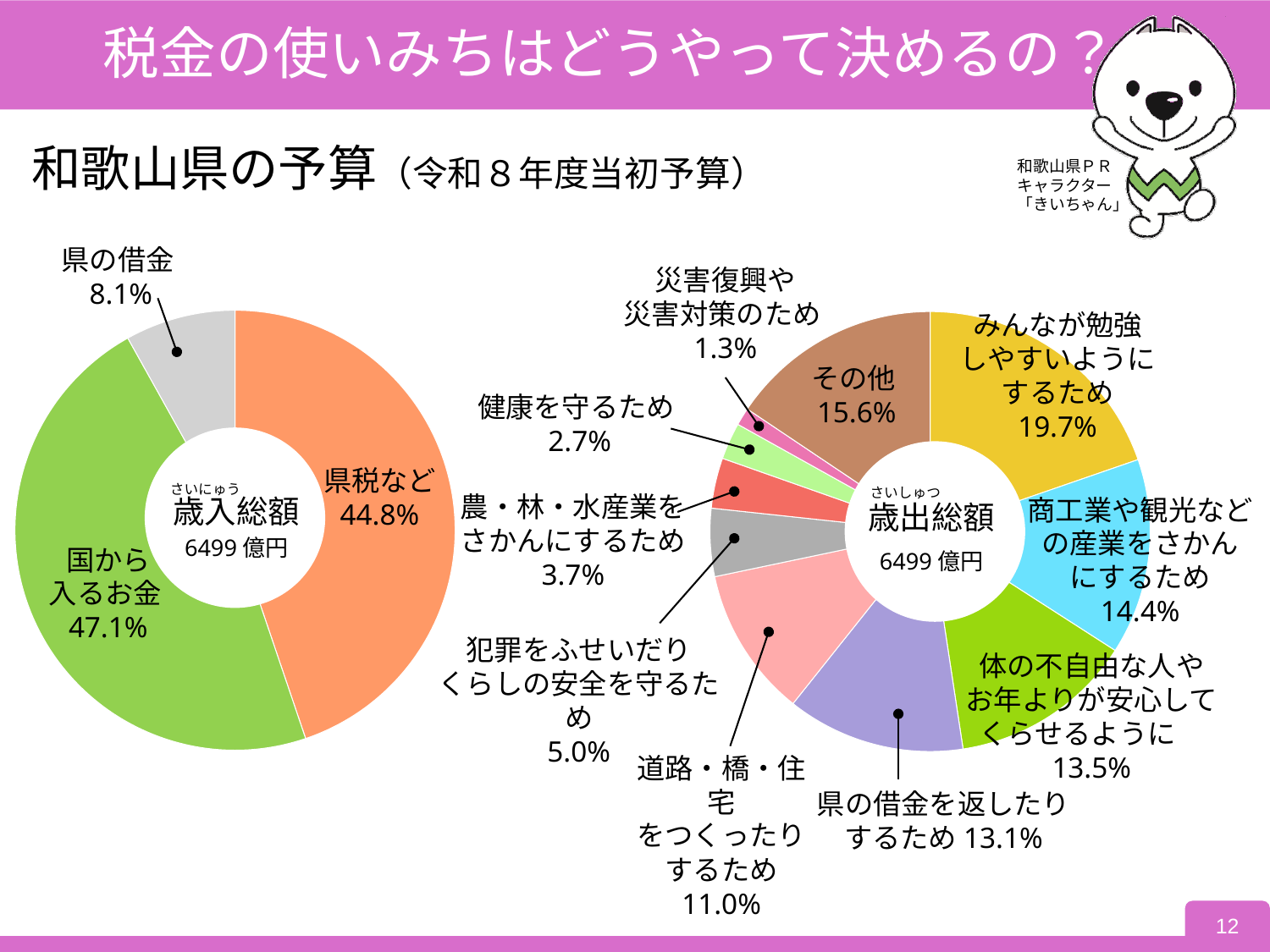
右の「歳出総額」のグラフで、最も割合が小さい項目はどれですか？ 災害復興や災害対策のため このスライドのグラフはどの種類のグラフですか？ 円グラフ（ドーナツグラフ） 右の「歳出総額」のグラフで、「その他」と「道路・橋・住宅をつくったりするため」では、どちらの割合が大きいですか？ その他 右の「歳出総額」のグラフには、いくつの項目がありますか？ 10 左の「歳入総額」のグラフには、いくつの項目がありますか？ 3 左の「歳入総額」のグラフの中央に書かれている総額はいくらですか？ 6499 億円 左の「歳入総額」のグラフで、最も割合が大きい項目はどれですか？ 国から入るお金 左の「歳入総額」のグラフで、「県税など」の割合はいくらですか？ 44.8% 右の「歳出総額」のグラフで、「みんなが勉強しやすいようにするため」の割合はいくらですか？ 19.7% 左の「歳入総額」のグラフで、「国から入るお金」と「県税など」の割合の差はいくらですか？ 2.3% 左の「歳入総額」のグラフで、最も割合が小さい項目はどれですか？ 県の借金 右の「歳出総額」のグラフで、「商工業や観光などの産業をさかんにするため」と「健康を守るため」の割合の差はいくらですか？ 11.7%